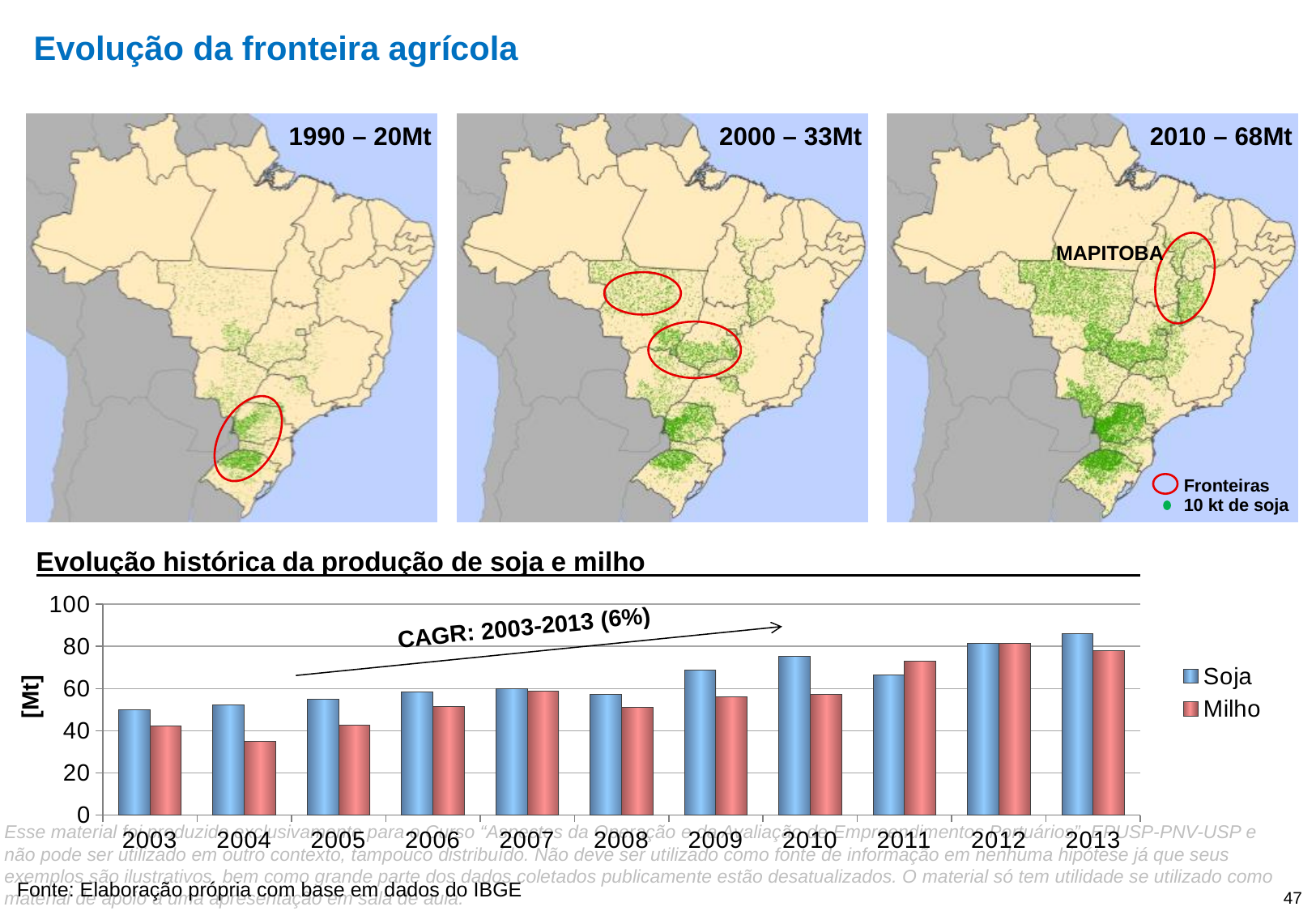
In the bar chart, is the Milho value for 2004 greater or less than 40? less In the bar chart, which is larger in 2004, Soja or Milho? Soja What CAGR for 2003-2013 is annotated on the bar chart? 6% In the bar chart, which is larger in 2011, Soja or Milho? Milho In the bar chart, does the Soja series generally rise or fall from 2003 to 2013? rise In the bar chart, which year has the lowest Soja value? 2003 In the bar chart, which year has the lowest Milho value? 2004 What kind of chart is 'Evolução histórica da produção de soja e milho'? bar chart In the bar chart, is the Soja value for 2013 greater or less than 80? greater How many years are shown on the x axis of the bar chart? 11 In the bar chart, which year has the highest Soja value? 2013 How many series does the legend of the bar chart list? 2